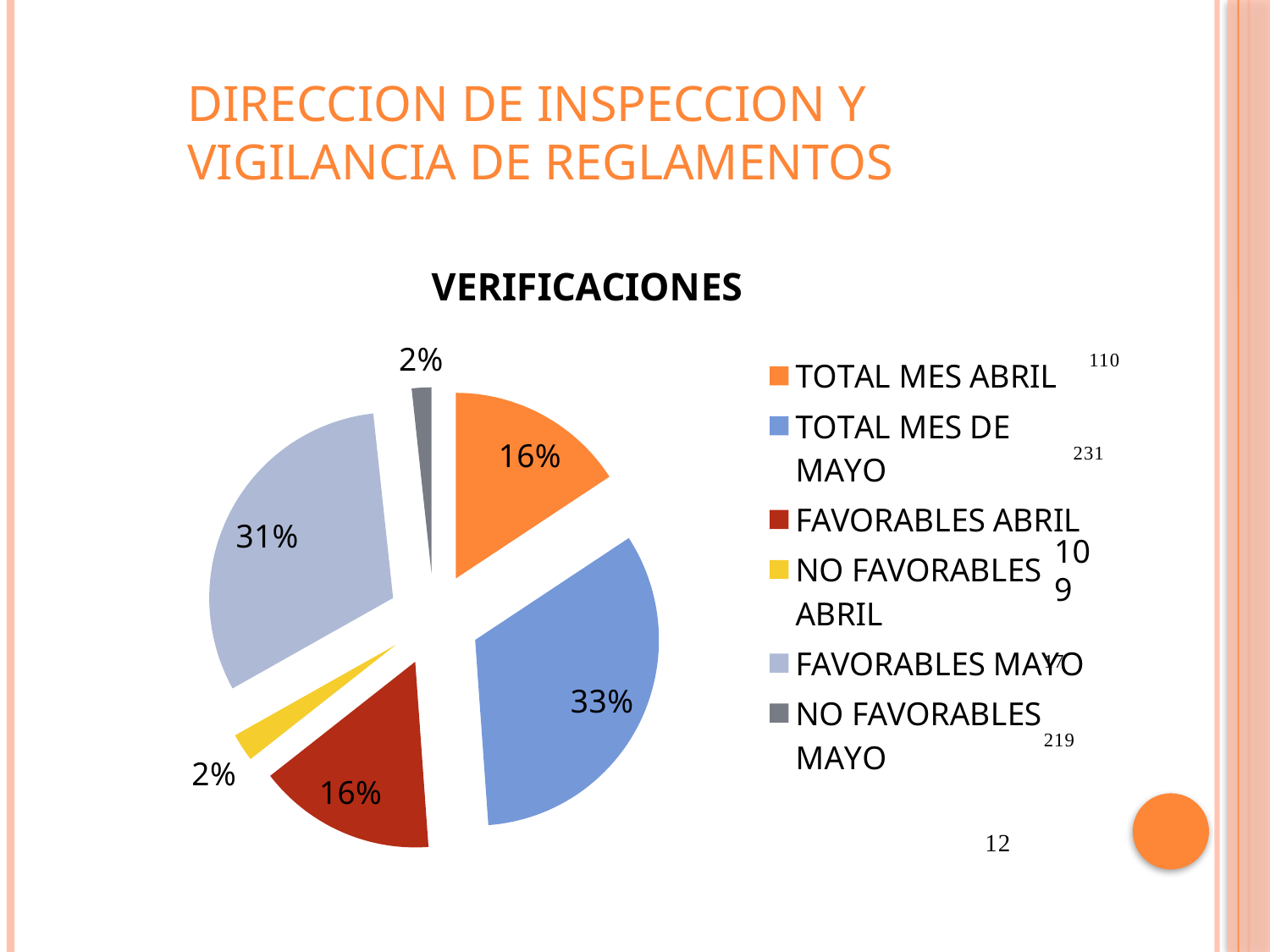
Which category has the largest slice of the pie? TOTAL MES DE MAYO What share of the pie does TOTAL MES DE MAYO represent? 33% How many slices does the pie chart have? 6 Which is larger, the slice for TOTAL MES DE MAYO or the slice for FAVORABLES MAYO? TOTAL MES DE MAYO What is the title of the chart? VERIFICACIONES What is the difference in percentage points between the TOTAL MES DE MAYO slice and the TOTAL MES ABRIL slice? 17 What share of the pie does TOTAL MES ABRIL represent? 16% How many entries does the legend list? 6 What share of the pie does FAVORABLES MAYO represent? 31% What kind of chart is shown on the slide? pie chart